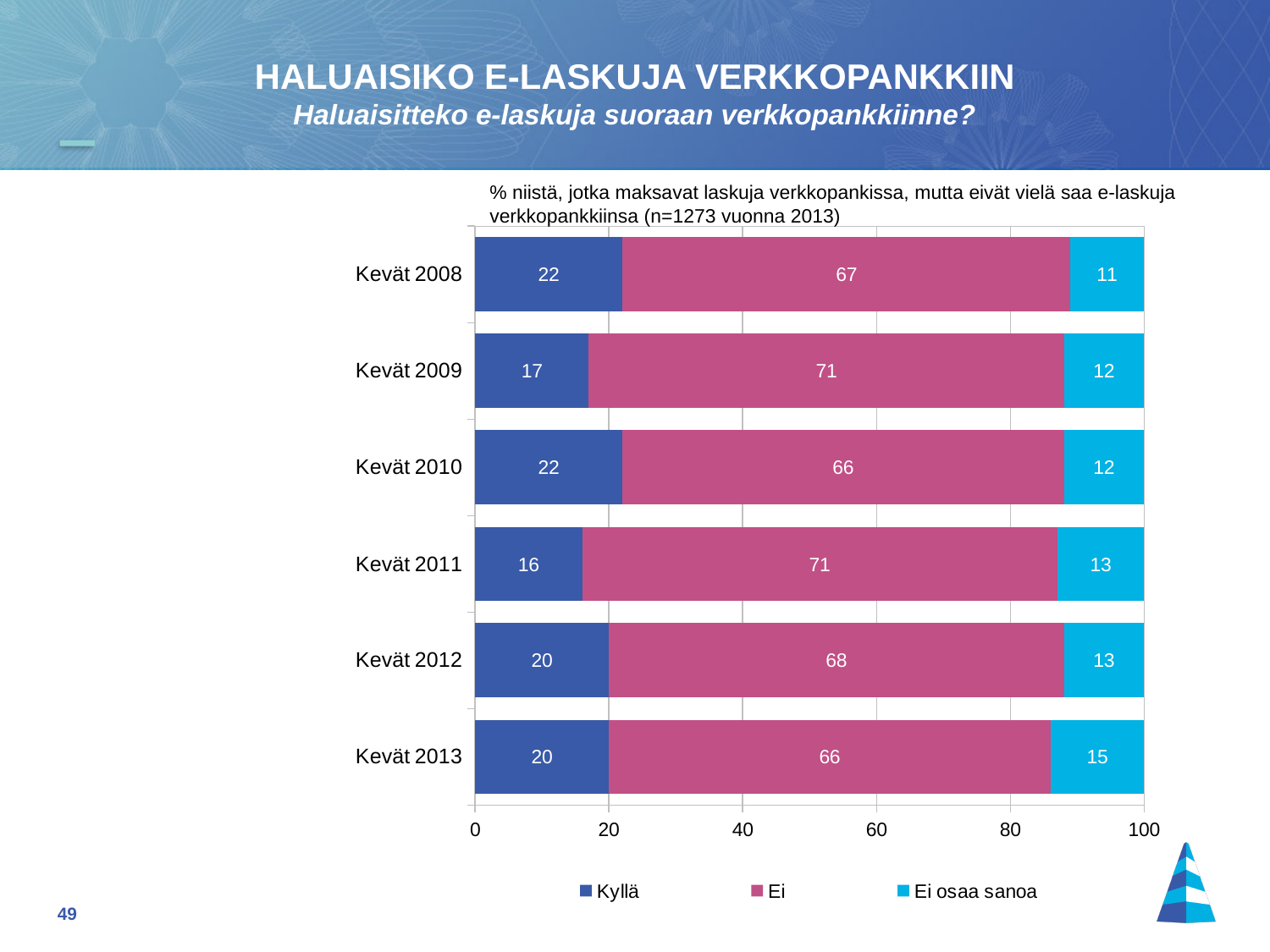
Which year has the lowest value for Kyllä? Kevät 2011 What is the total of the stacked bar for Kevät 2012? 101 How many years (categories) are shown on the chart? 6 What is the difference between the Ei value for Kevät 2009 and the Ei value for Kevät 2013? 5 What is the value for Kyllä in Kevät 2008? 22 How many series does the legend list? 3 Which series is shown in pink on the chart? Ei What is the value for Ei osaa sanoa in Kevät 2013? 15 What kind of chart is shown on the slide? Stacked bar chart What is the value for Ei in Kevät 2011? 71 Which is larger: the Kyllä value for Kevät 2010 or the Kyllä value for Kevät 2012? Kevät 2010 Which year has the highest value for Ei osaa sanoa? Kevät 2013